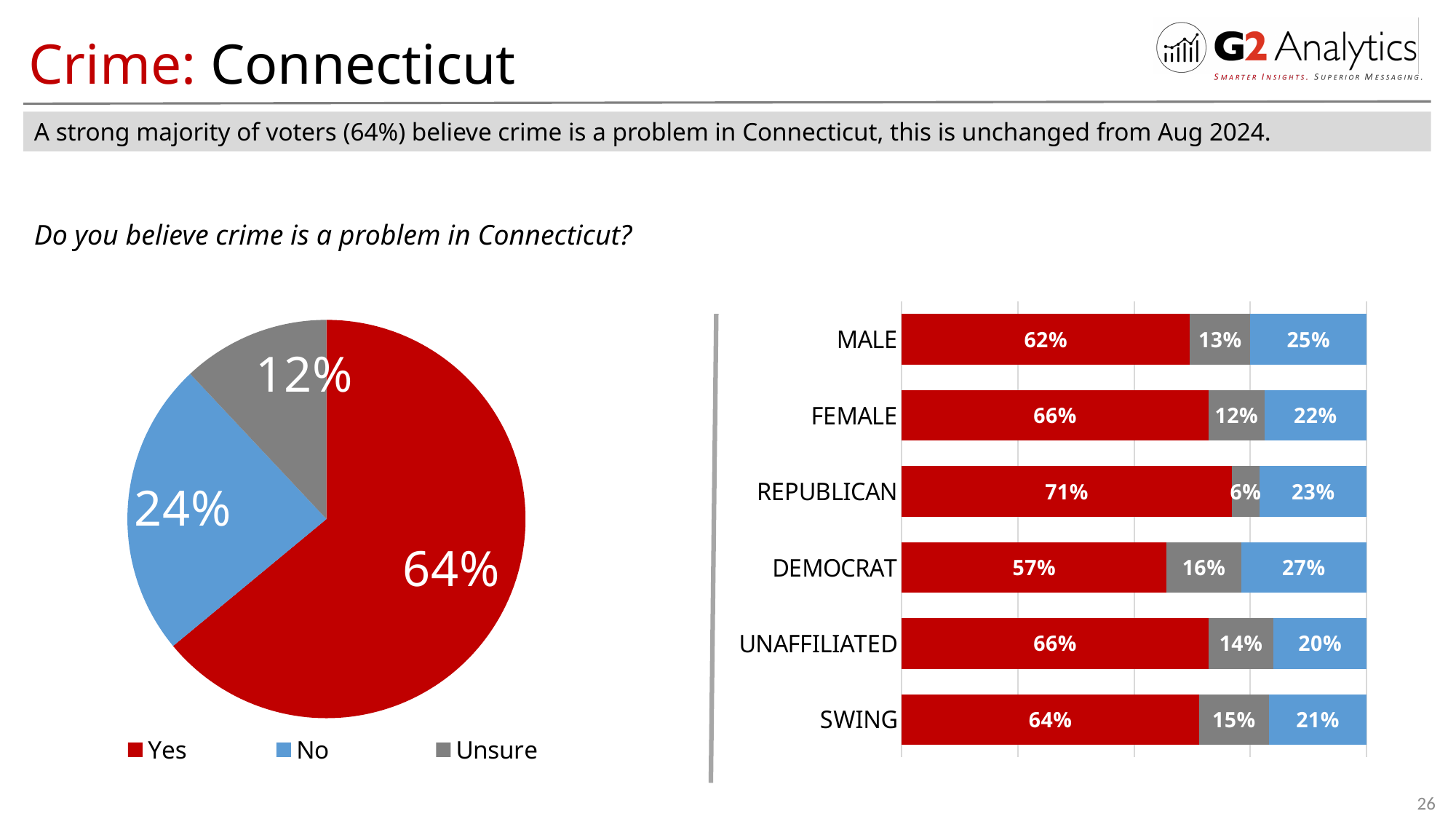
In the bar chart on the right, how many groups are shown? 6 In the bar chart on the right, what is the No value for DEMOCRAT? 27% In the pie chart on the left, how many entries does the legend list? 3 In the bar chart on the right, what is the difference between the Yes values for FEMALE and MALE? 4% In the bar chart on the right, which group has the lowest Yes value? DEMOCRAT In the bar chart on the right, what is the Yes value for REPUBLICAN? 71% In the bar chart on the right, which group has the highest Yes value? REPUBLICAN In the pie chart on the left, what share of voters answered Yes? 64% In the pie chart on the left, which response has the smallest slice? Unsure What kind of chart is on the right side of the slide? Bar chart In the pie chart on the left, what share of voters answered Unsure? 12% In the bar chart on the right, what is the Unsure value for SWING? 15%